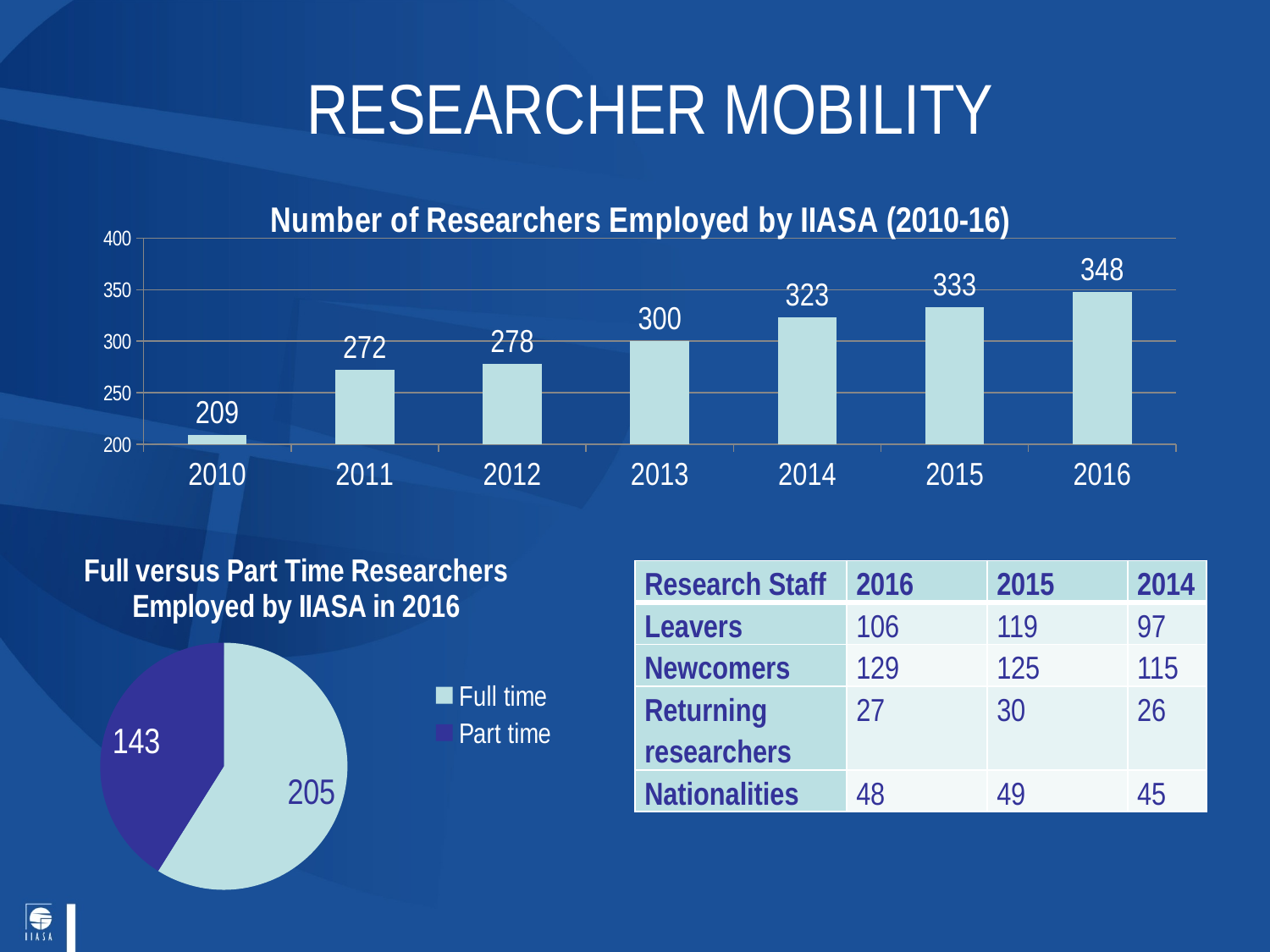
In the 'Number of Researchers Employed by IIASA (2010-16)' chart, what is the value for 2010? 209 In the 'Full versus Part Time Researchers Employed by IIASA in 2016' pie chart, what is the value for Part time? 143 In the 'Number of Researchers Employed by IIASA (2010-16)' chart, how many years are shown on the x axis? 7 In the 'Full versus Part Time Researchers Employed by IIASA in 2016' pie chart, which slice is larger, Full time or Part time? Full time In the 'Number of Researchers Employed by IIASA (2010-16)' chart, which year has the highest value? 2016 In the 'Number of Researchers Employed by IIASA (2010-16)' chart, what is the difference between the values for 2016 and 2015? 15 How many entries does the legend of the 'Full versus Part Time Researchers Employed by IIASA in 2016' pie chart list? 2 What kind of chart is 'Number of Researchers Employed by IIASA (2010-16)'? Bar chart In the 'Number of Researchers Employed by IIASA (2010-16)' chart, which is larger, the value for 2011 or the value for 2012? 2012 In the 'Number of Researchers Employed by IIASA (2010-16)' chart, which year has the lowest value? 2010 In the 'Number of Researchers Employed by IIASA (2010-16)' chart, do the values rise or fall from 2010 to 2016? Rise In the 'Number of Researchers Employed by IIASA (2010-16)' chart, what is the value for 2013? 300